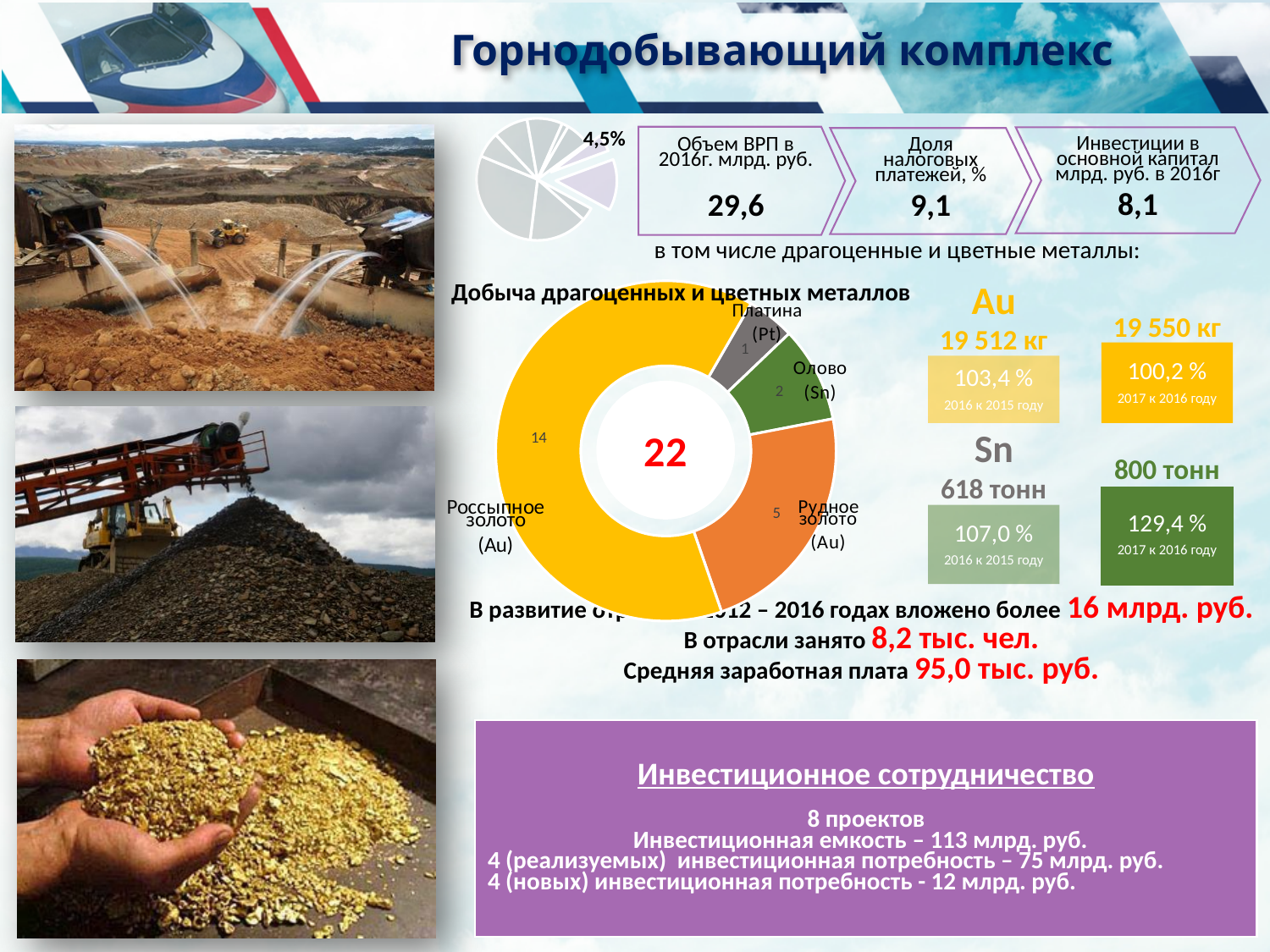
In the 'Добыча драгоценных и цветных металлов' chart, what is the value for Рудное золото (Au)? 5 In the 'Добыча драгоценных и цветных металлов' chart, which category has the largest value? Россыпное золото (Au) What type of chart is the 'Добыча драгоценных и цветных металлов' chart? doughnut chart How many categories are shown in the 'Добыча драгоценных и цветных металлов' chart? 4 In the 'Добыча драгоценных и цветных металлов' chart, what is the value for Платина (Pt)? 1 In the 'Добыча драгоценных и цветных металлов' chart, which is larger: Олово (Sn) or Рудное золото (Au)? Рудное золото (Au) What number is shown in the centre of the 'Добыча драгоценных и цветных металлов' doughnut chart? 22 In the 'Добыча драгоценных и цветных металлов' chart, what is the difference between Россыпное золото (Au) and Рудное золото (Au)? 9 In the 'Добыча драгоценных и цветных металлов' chart, what is the value for Олово (Sn)? 2 In the 'Добыча драгоценных и цветных металлов' chart, what is the value for Россыпное золото (Au)? 14 In the 'Добыча драгоценных и цветных металлов' chart, which category has the smallest value? Платина (Pt) What percentage label is shown on the small pie chart at the top of the slide? 4,5%